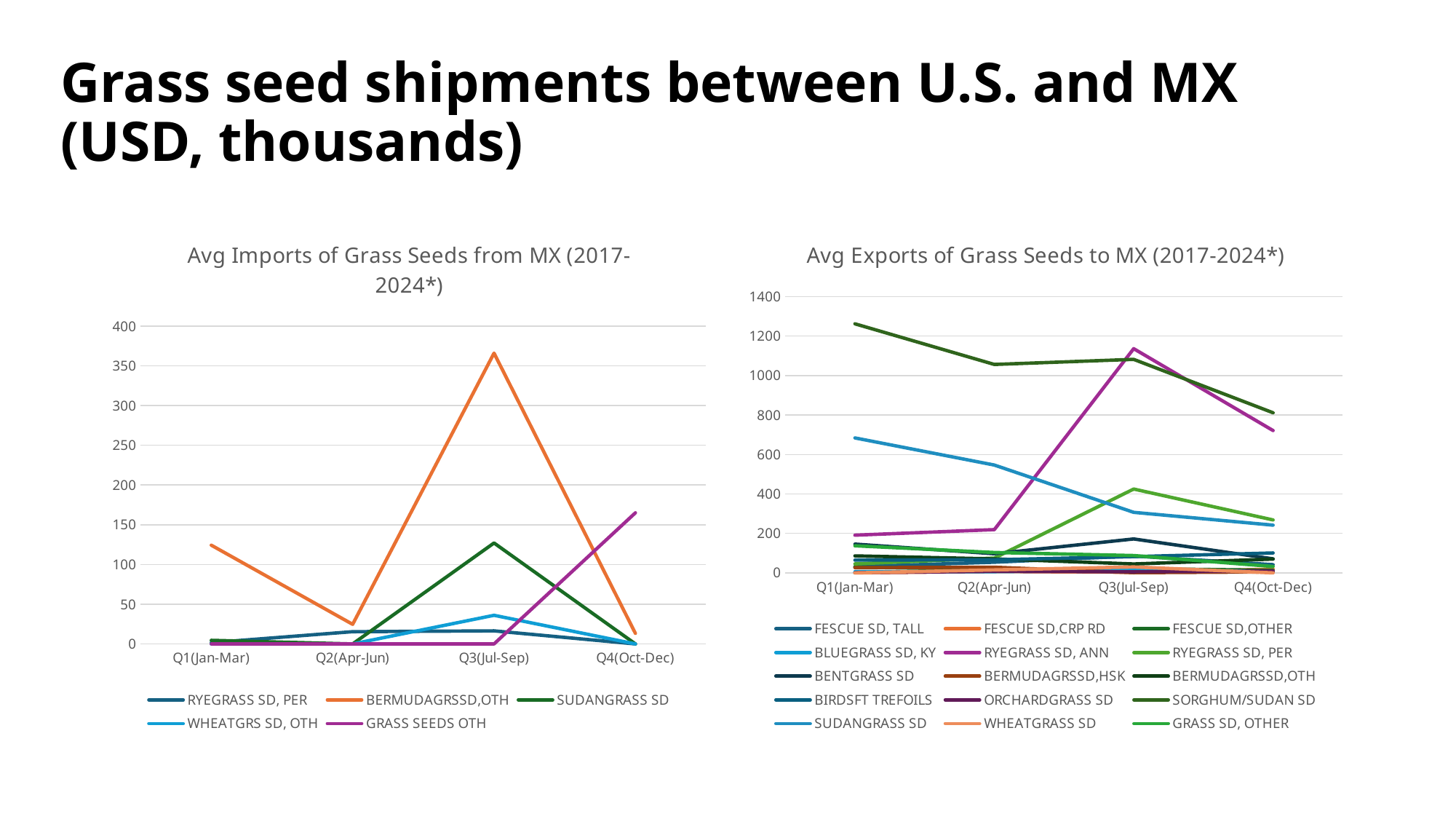
How many series does the legend of the 'Avg Imports of Grass Seeds from MX (2017-2024*)' chart list? 5 In the 'Avg Exports of Grass Seeds to MX (2017-2024*)' chart, which series has the highest value in Q1(Jan-Mar)? SORGHUM/SUDAN SD In the 'Avg Imports of Grass Seeds from MX (2017-2024*)' chart, which is larger in Q3(Jul-Sep): SUDANGRASS SD or WHEATGRS SD, OTH? SUDANGRASS SD How many quarters are shown on the x axis of the 'Avg Imports of Grass Seeds from MX (2017-2024*)' chart? 4 In the 'Avg Exports of Grass Seeds to MX (2017-2024*)' chart, is the value for RYEGRASS SD, ANN in Q3(Jul-Sep) greater or less than 1000? greater In the 'Avg Exports of Grass Seeds to MX (2017-2024*)' chart, does the SUDANGRASS SD line rise or fall from Q1(Jan-Mar) to Q4(Oct-Dec)? fall In the 'Avg Imports of Grass Seeds from MX (2017-2024*)' chart, is the value for BERMUDAGRSSD,OTH in Q2(Apr-Jun) greater or less than 50? less In the 'Avg Exports of Grass Seeds to MX (2017-2024*)' chart, is the value for SORGHUM/SUDAN SD in Q1(Jan-Mar) greater or less than 1200? greater How many series does the legend of the 'Avg Exports of Grass Seeds to MX (2017-2024*)' chart list? 15 What type of chart is the 'Avg Imports of Grass Seeds from MX (2017-2024*)' chart? line chart In the 'Avg Imports of Grass Seeds from MX (2017-2024*)' chart, which series has the highest value in Q4(Oct-Dec)? GRASS SEEDS OTH